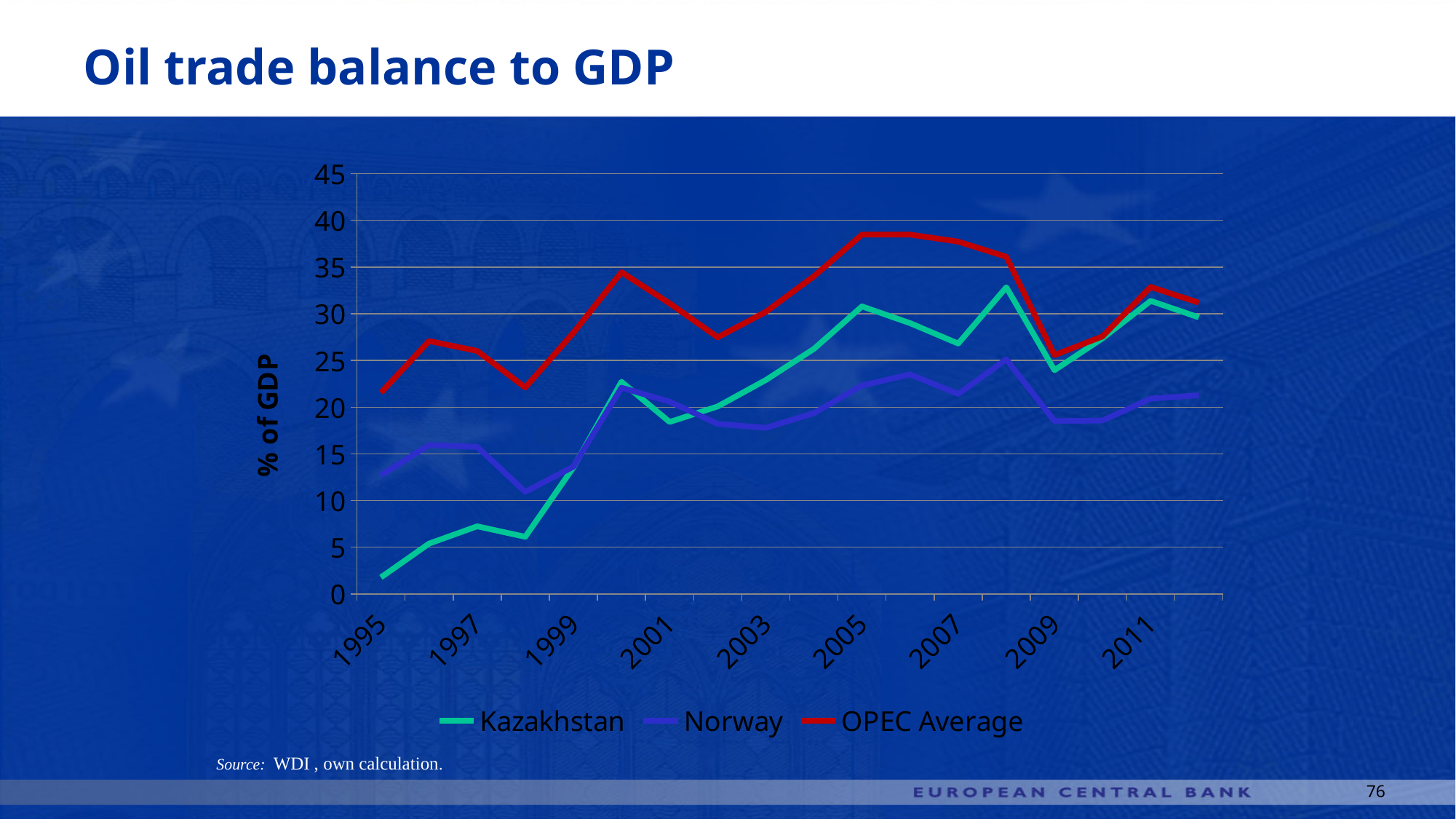
Which series has the highest value in 2005? OPEC Average Is the value for OPEC Average in 2005 greater or less than 35? greater Does the Kazakhstan line rise or fall from 1995 to 2000? rise Is the value for OPEC Average in 2000 greater or less than 30? greater Is the value for Norway in 2003 greater or less than 20? less What kind of chart is shown on the slide? line chart In 1995, which is higher: Norway or Kazakhstan? Norway What is the label on the vertical axis? % of GDP Which series are listed in the legend? Kazakhstan, Norway, OPEC Average In 2005, which is higher: Kazakhstan or Norway? Kazakhstan How many series does the legend list? 3